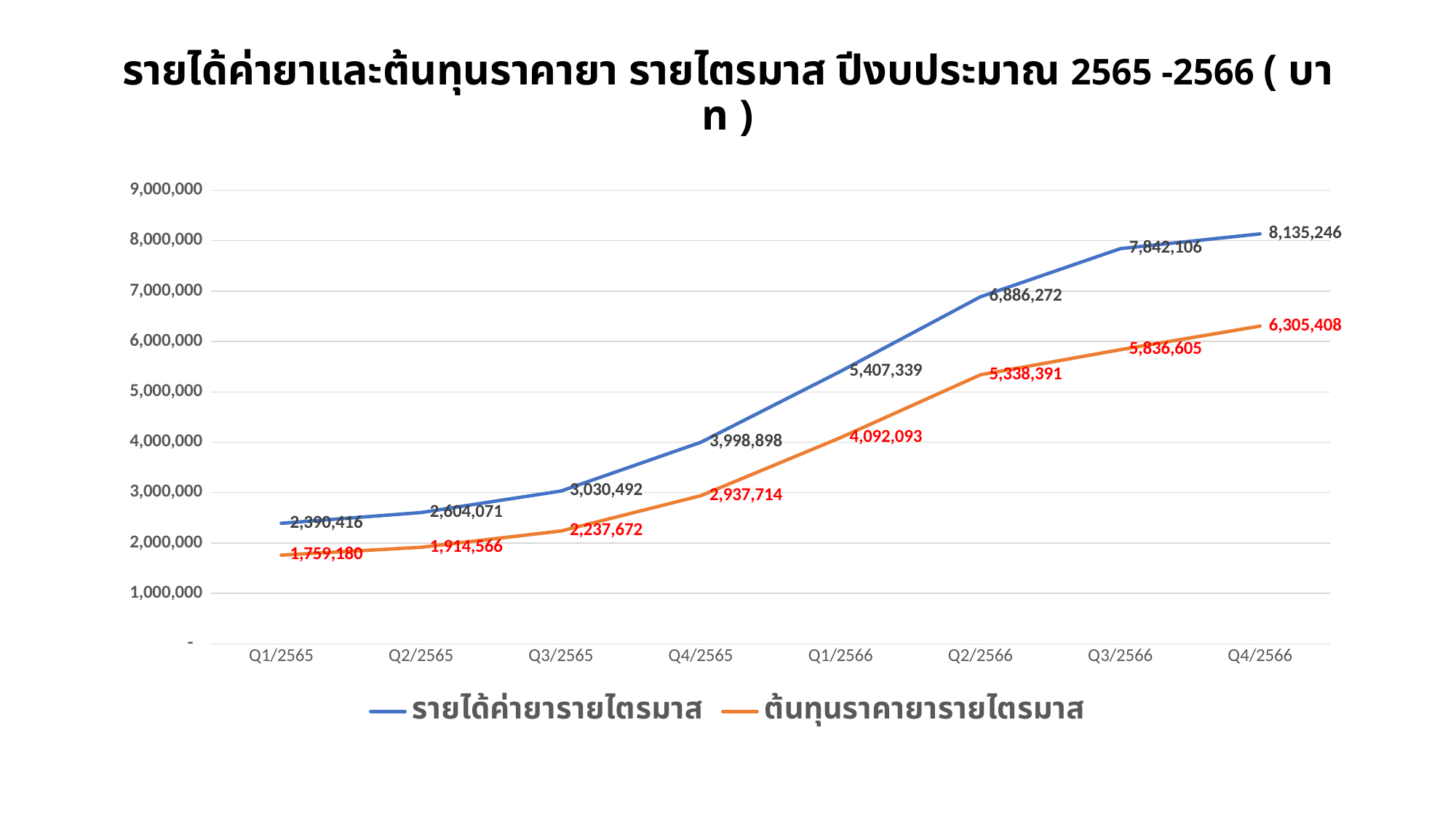
Which colour is used for the ต้นทุนราคายารายไตรมาส line? orange How many quarters are plotted along the x axis? 8 What is the difference between รายได้ค่ายารายไตรมาส and ต้นทุนราคายารายไตรมาส in Q4/2566? 1,829,838 How many series does the legend list? 2 What is the value of ต้นทุนราคายารายไตรมาส for Q2/2566? 5,338,391 What is the value of รายได้ค่ายารายไตรมาส for Q4/2566? 8,135,246 In which quarter is รายได้ค่ายารายไตรมาส highest? Q4/2566 What type of chart is shown on the slide? line chart What is the value of ต้นทุนราคายารายไตรมาส for Q1/2565? 1,759,180 Which is larger in Q1/2566: รายได้ค่ายารายไตรมาส or ต้นทุนราคายารายไตรมาส? รายได้ค่ายารายไตรมาส Do the values of รายได้ค่ายารายไตรมาส rise or fall from Q1/2565 to Q4/2566? rise In which quarter is ต้นทุนราคายารายไตรมาส lowest? Q1/2565